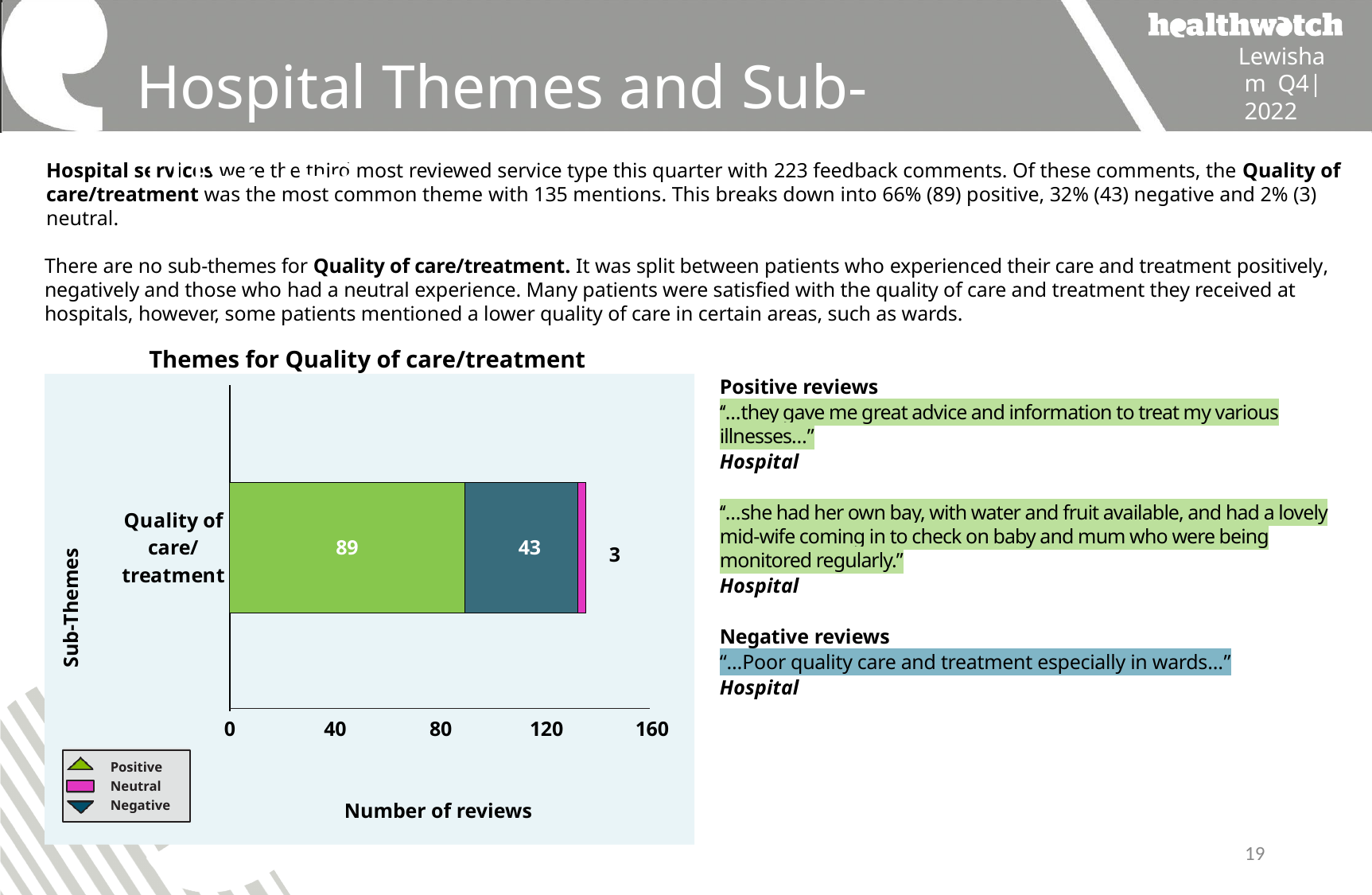
What kind of chart is shown? Stacked bar chart Which series has the lowest value for Quality of care/treatment? Neutral What is the value for Negative reviews for Quality of care/treatment? 43 What is the value for Positive reviews for Quality of care/treatment? 89 How many series does the legend list? 3 Which is larger for Quality of care/treatment, the Positive value or the Negative value? Positive What is the difference between the Positive and Negative values for Quality of care/treatment? 46 What is the value for Neutral reviews for Quality of care/treatment? 3 What is the total of the stacked bar for Quality of care/treatment? 135 How many categories are shown on the y axis? 1 Which series has the highest value for Quality of care/treatment? Positive What is the title of the chart? Themes for Quality of care/treatment